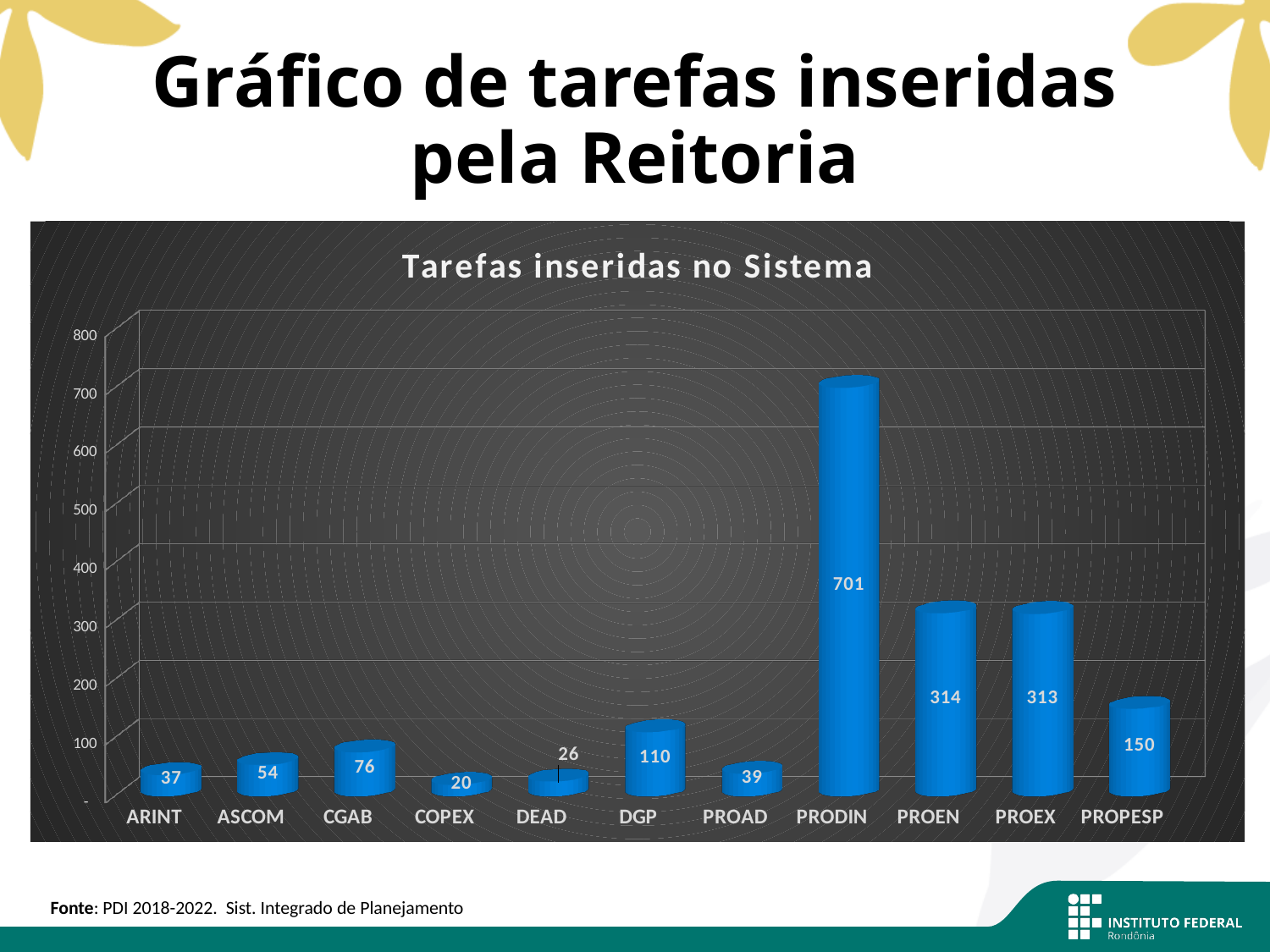
What is the value for PROPESP? 150 Is the value for PROEX greater or less than 200? greater What is the title of the chart? Tarefas inseridas no Sistema What kind of chart is shown on the slide? Bar chart How many tasks are shown for DGP? 110 Which category has the highest value? PRODIN What is the difference between the values for PRODIN and PROEN? 387 Which is larger, the value for DGP or the value for PROAD? DGP Which category has the lowest value? COPEX What is the value for PRODIN in the chart? 701 How many categories are shown on the x axis? 11 What is the difference between the values for CGAB and ARINT? 39